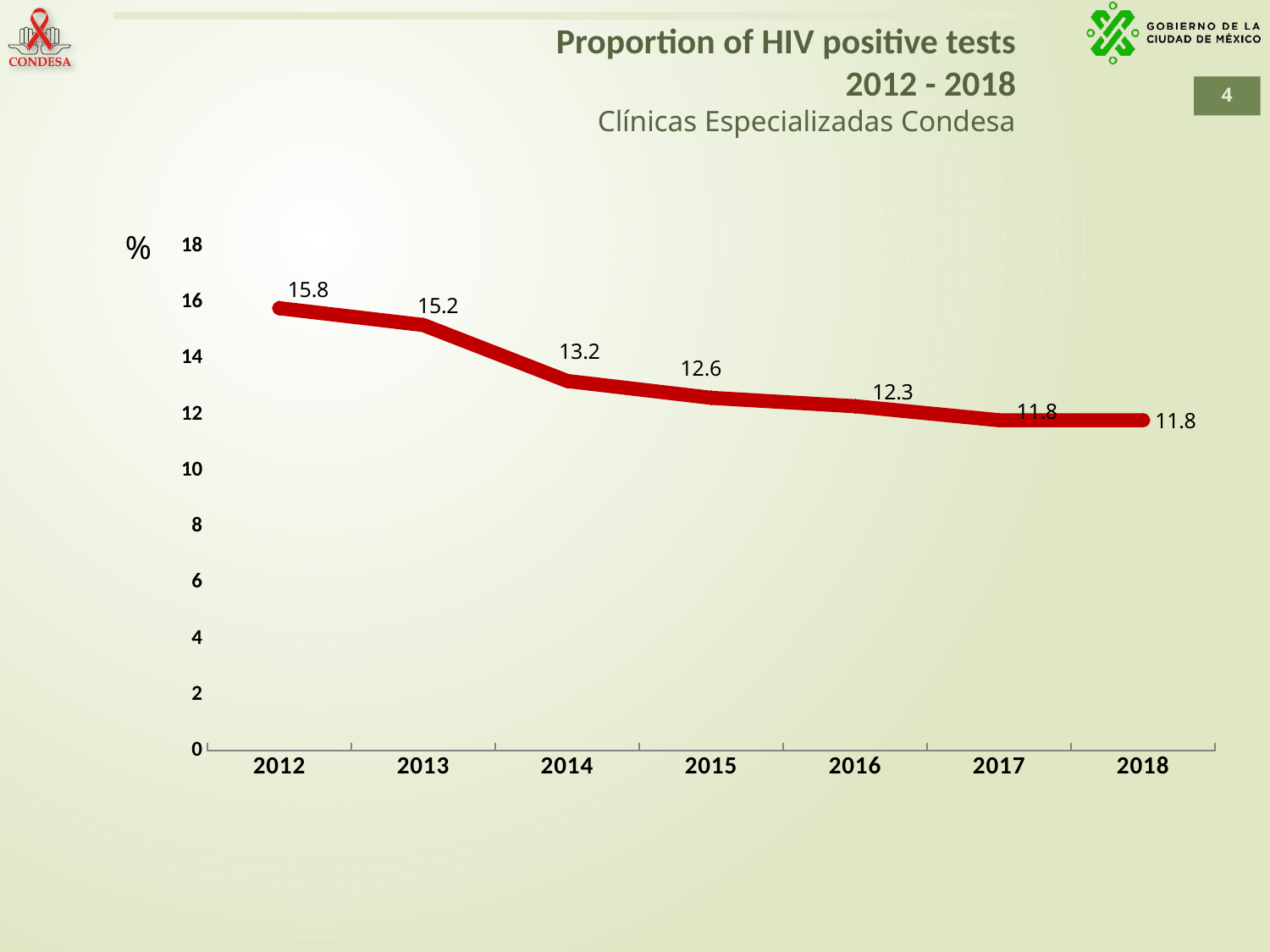
Which is larger, the value for 2015 or the value for 2016? 2015 Is the value for 2017 greater or less than 14? less What is the proportion of HIV positive tests in 2014? 13.2 Which year has the highest proportion of HIV positive tests? 2012 What is the proportion of HIV positive tests in 2016? 12.3 What is the proportion of HIV positive tests in 2018? 11.8 What is the difference between the 2012 value and the 2018 value? 4.0 What is the proportion of HIV positive tests in 2012? 15.8 What is the difference between the 2013 value and the 2014 value? 2.0 Do the values rise or fall from 2012 to 2018? fall What kind of chart is shown on the slide? line chart How many years are plotted on the chart? 7